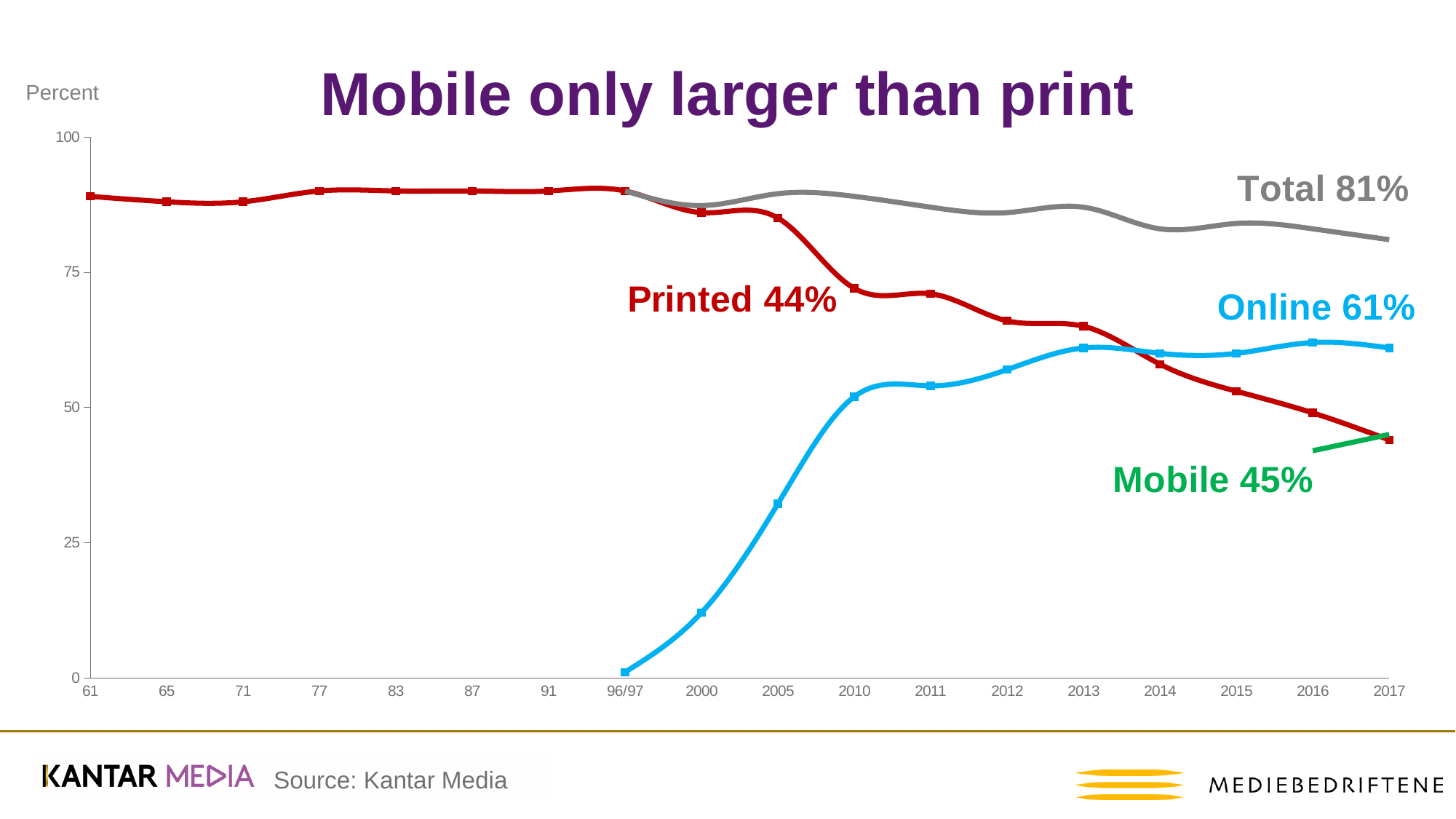
What is the labelled value for Online? 61% What is the title of the chart? Mobile only larger than print What is the difference between the labelled Online value and the labelled Printed value? 17 percentage points Is the value for Online in 2005 greater or less than 50? less Which series has the lowest labelled value? Printed What is the labelled value for Mobile? 45% Does the Printed line rise or fall from 96/97 to 2017? fall Which is larger, the labelled Mobile value or the labelled Printed value? Mobile What is the labelled value for Printed? 44% What kind of chart is shown on the slide? line chart What is the labelled value for Total? 81% Which series has the highest labelled value? Total